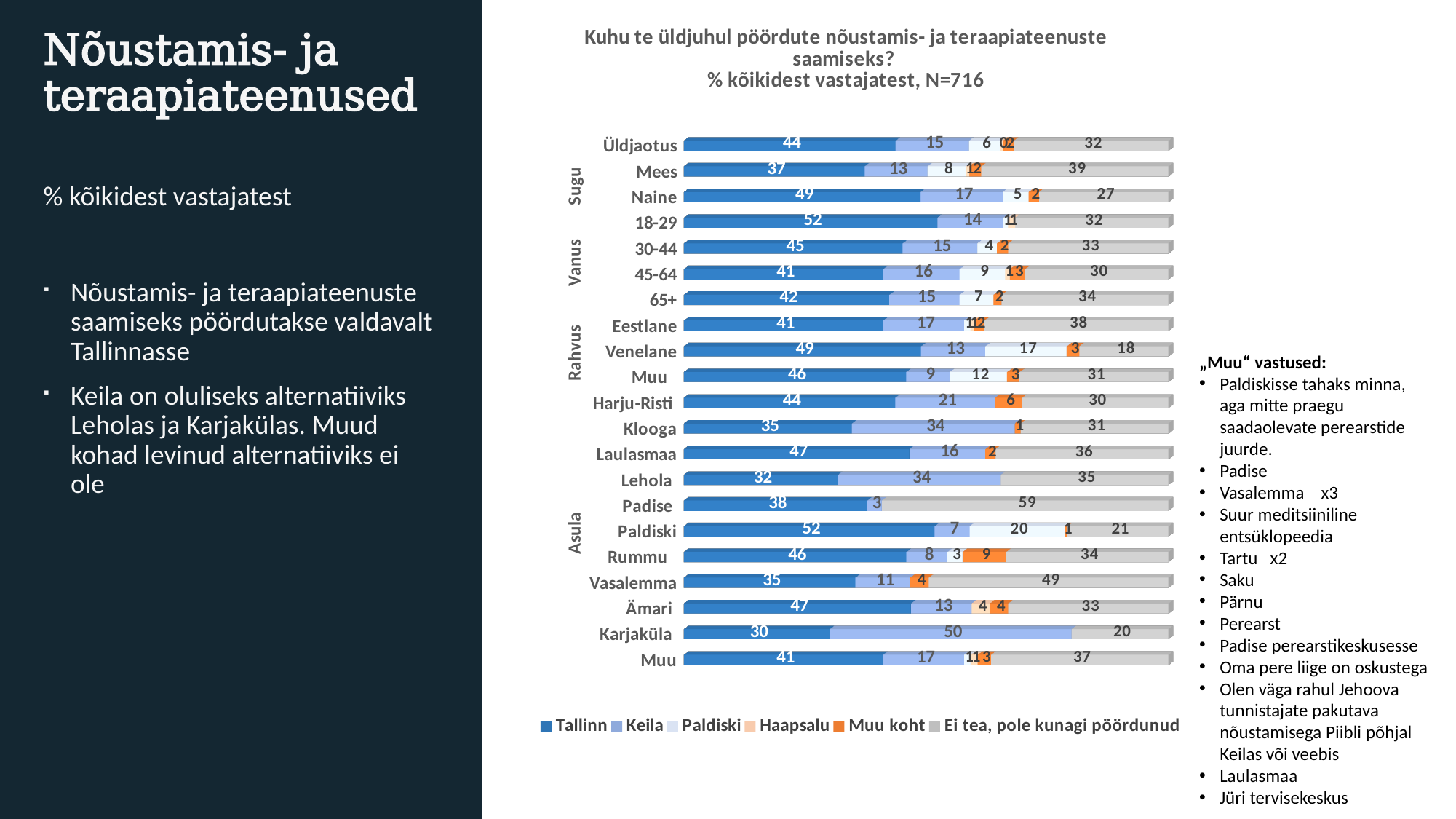
What is the Tallinn value for Üldjaotus? 44 Which has the larger Tallinn value, Mees or Naine? Naine What is the 'Muu koht' value for Rummu? 9 How many series does the chart legend list? 6 Which category has the lowest Tallinn value? Karjaküla What is the Tallinn value for Karjaküla? 30 What is the Keila value for Karjaküla? 50 What is the 'Ei tea, pole kunagi pöördunud' value for Padise? 59 What kind of chart is shown on the slide? bar chart Which category has the highest Keila value? Karjaküla What is the difference between the Tallinn values for Naine and Mees? 12 What is the N stated in the chart title? N=716